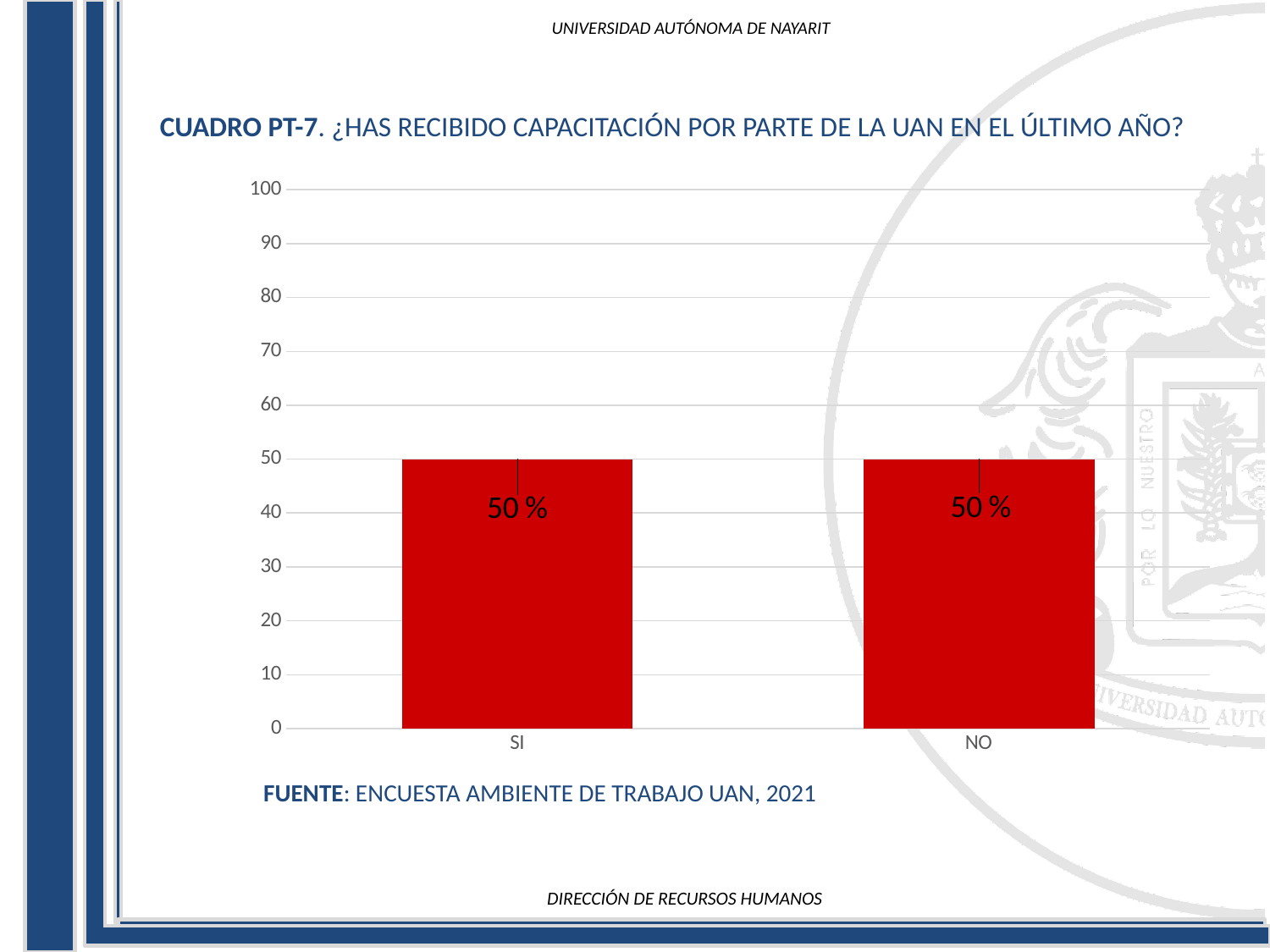
What is the difference between the values for SI and NO? 0 % Is the value for NO greater or less than 40? greater What is the total of the values for SI and NO? 100 % Is the value for SI greater or less than 60? less What is the value for NO? 50 % What is the maximum value shown on the y axis? 100 What is the value for SI? 50 % What kind of chart is shown on the slide? bar chart What colour are the bars in the chart? red How many categories are shown on the x axis? 2